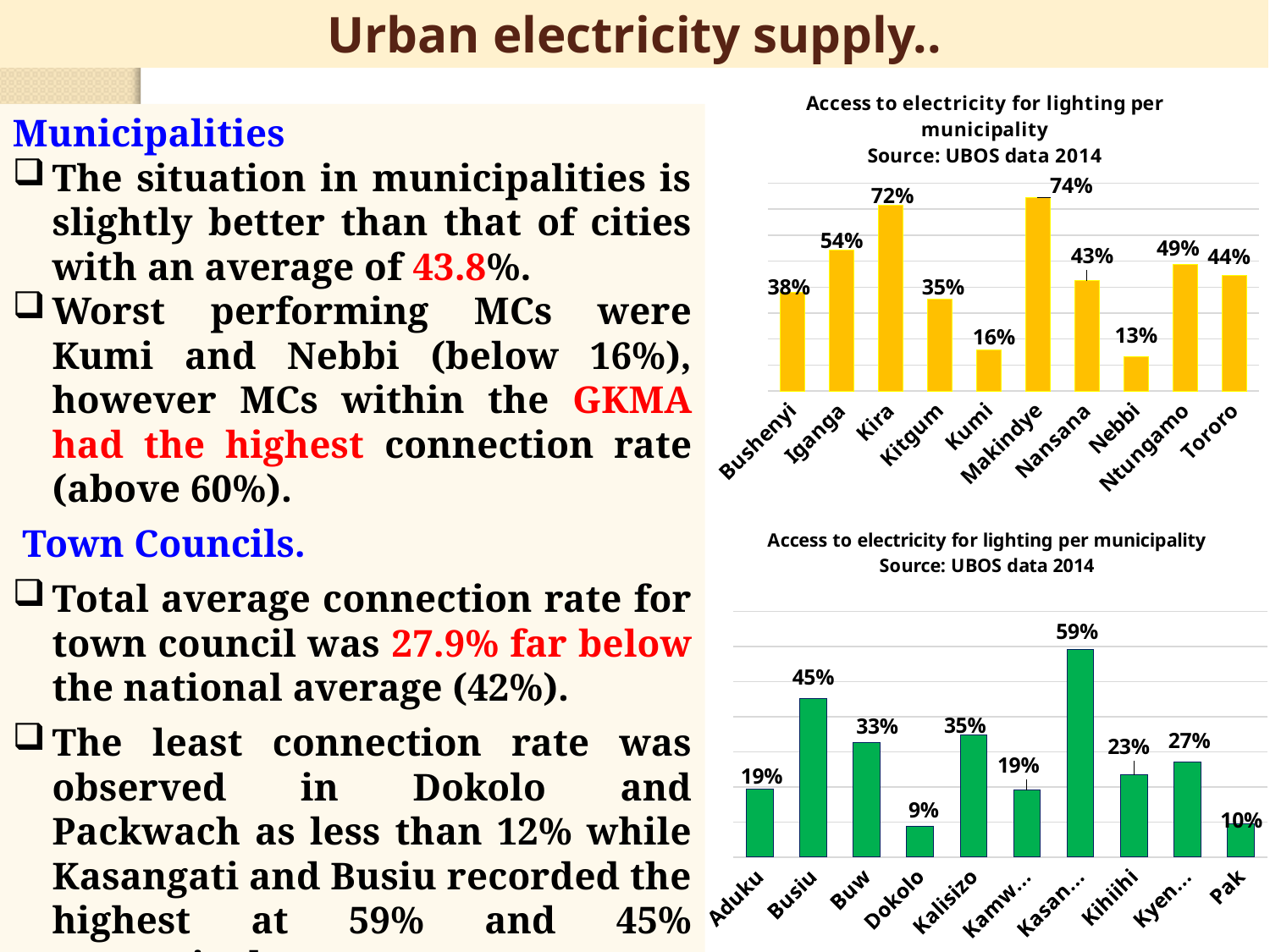
In the top chart, what is the value for Nansana? 43% In the top chart, what is the difference between the values for Iganga and Kitgum? 19% In the top chart, which is larger, the value for Ntungamo or the value for Tororo? Ntungamo In the top chart, what is the value for Kira? 72% What type of chart is the bottom chart? Bar chart In the top chart, which municipality has the highest value? Makindye In the top chart, which municipality has the lowest value? Nebbi In the bottom chart, which town council has the lowest value? Dokolo In the bottom chart, what is the difference between the values for Kalisizo and Aduku? 16% How many municipalities are shown in the top chart? 10 In the bottom chart, what is the value for Kihiihi? 23% In the bottom chart, what is the value for Busiu? 45%